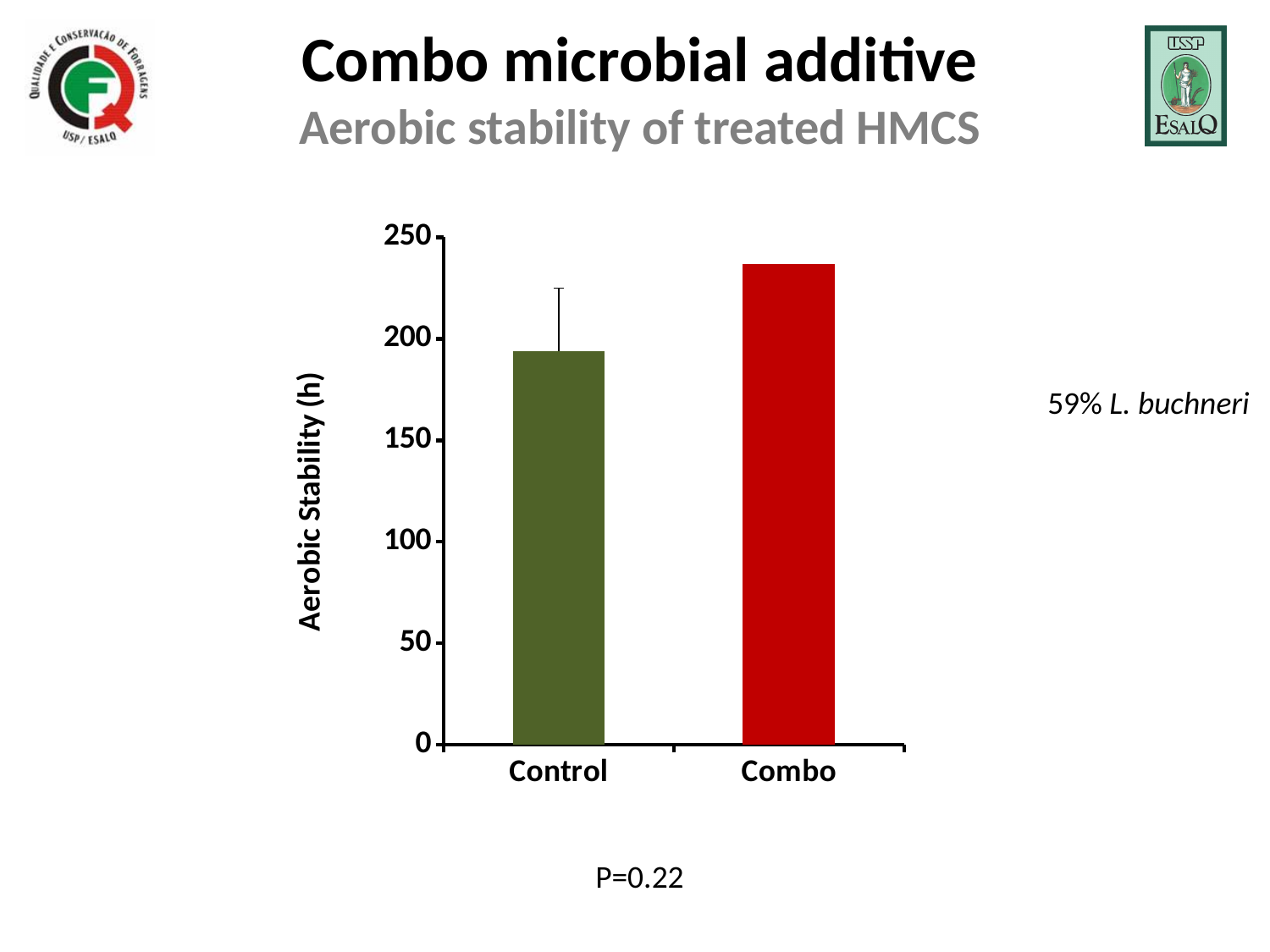
What is the label of the y axis? Aerobic Stability (h) Is the value for Control greater or less than 200? less Is the value for Control greater or less than 150? greater What kind of chart is shown on the slide? bar chart Which category has the highest aerobic stability? Combo What colour is the Combo bar? red Is the value for Combo greater or less than 200? greater Which category has the lowest aerobic stability? Control How many categories are plotted on the x axis? 2 Which is larger, the value for Control or the value for Combo? Combo